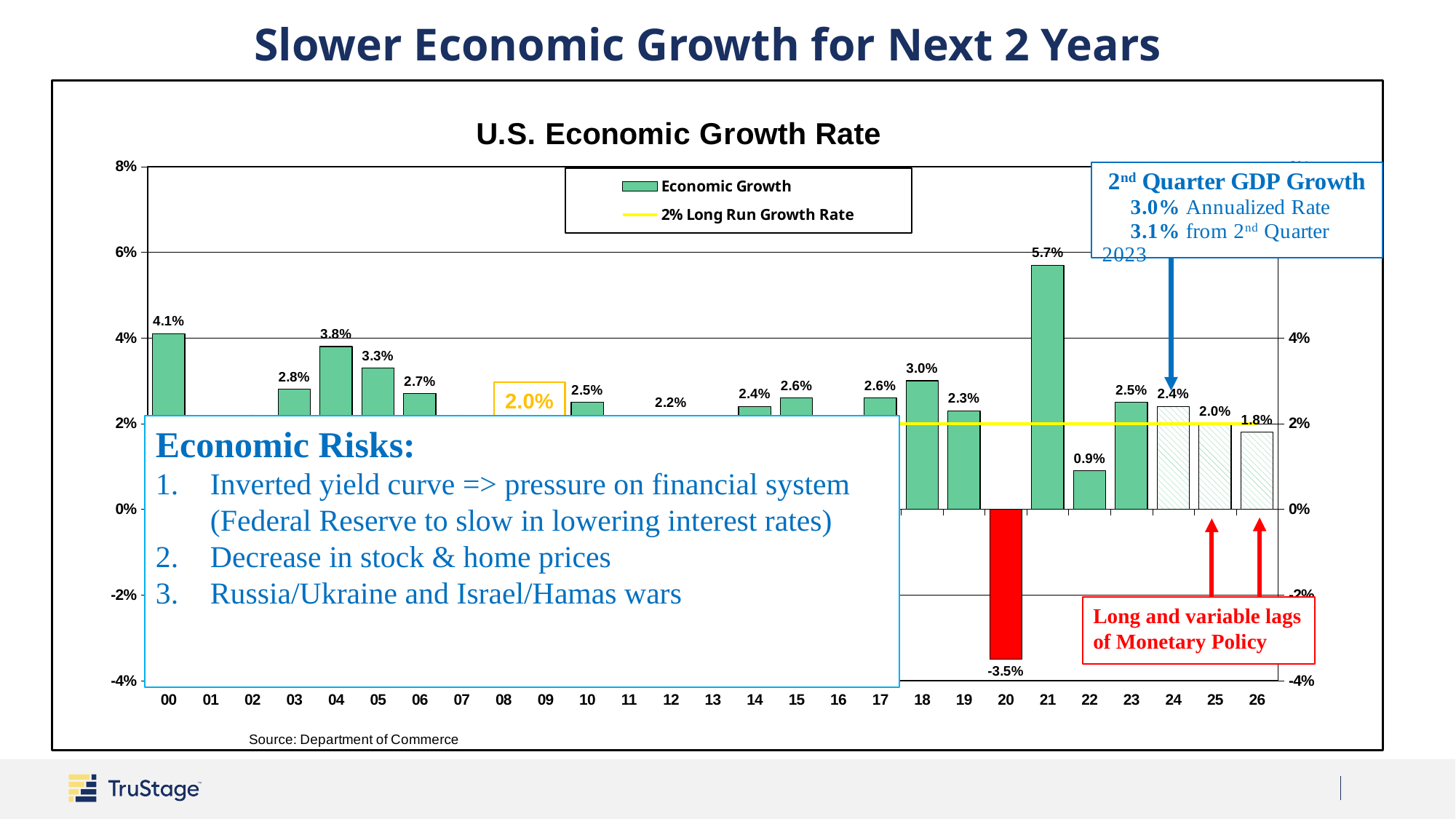
How many series does the chart legend list? 2 What kind of chart is used to show the U.S. Economic Growth Rate? bar chart What is the difference between the economic growth rates for 21 and 22? 4.8% Which year has the lowest economic growth rate on the chart? 20 What is the economic growth rate shown for 21? 5.7% Is the economic growth rate for 22 greater or less than 2%? less What is the economic growth rate shown for 20? -3.5% How many years are shown on the x axis of the chart? 27 Which year has the highest economic growth rate on the chart? 21 Which year has the larger economic growth rate, 04 or 05? 04 What is the economic growth rate shown for 26? 1.8% Do the economic growth rates rise or fall from 24 to 26? fall